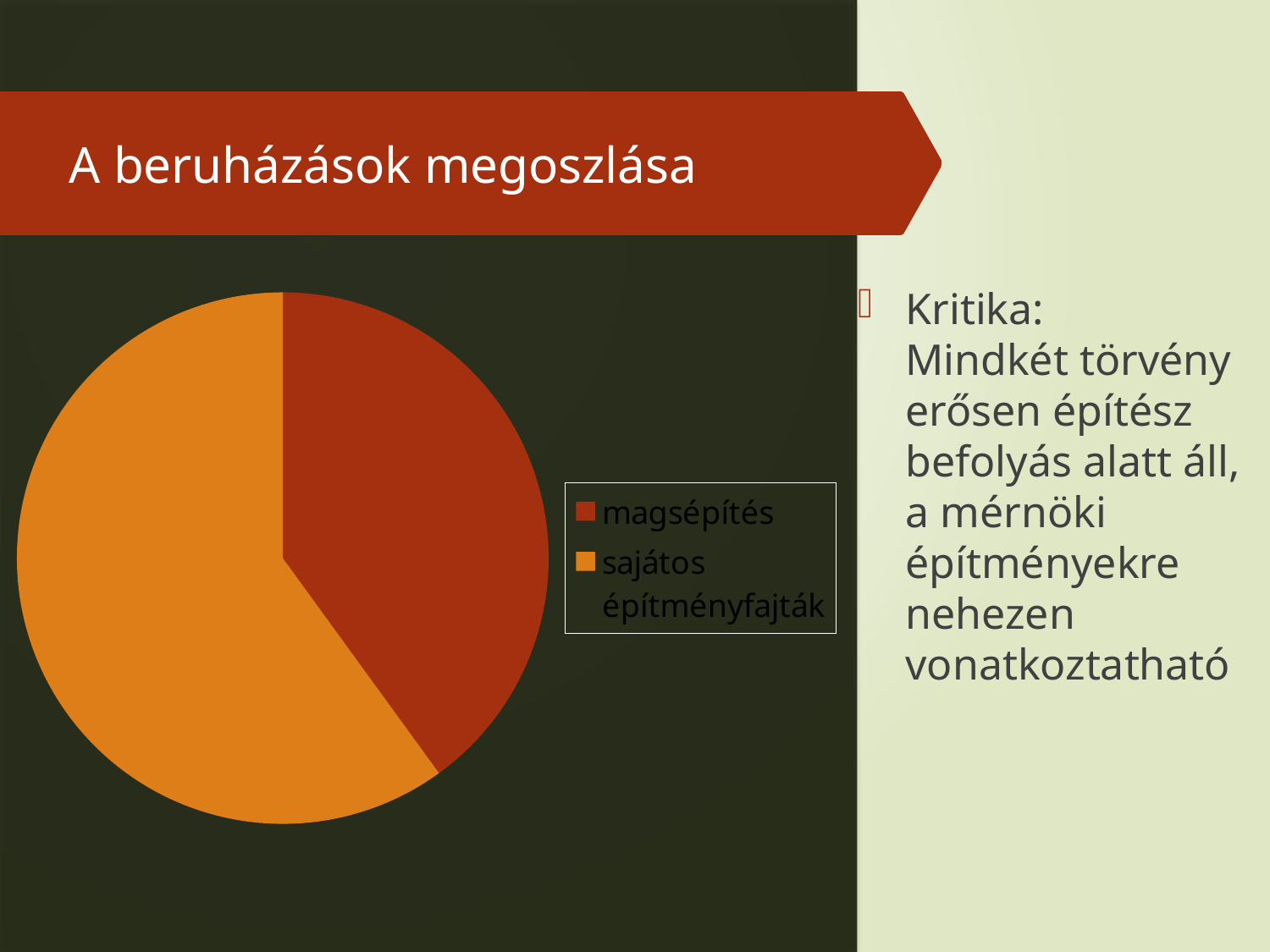
What colour is the slice for magsépítés in the pie chart? dark red Which category has the smallest slice in the pie chart? magsépítés What kind of chart is shown on the slide? pie chart Which slice is larger: magsépítés or sajátos építményfajták? sajátos építményfajták What is the title of the slide containing the pie chart? A beruházások megoszlása How many entries does the legend of the pie chart list? 2 Which category has the largest slice in the pie chart? sajátos építményfajták How many slices does the pie chart have? 2